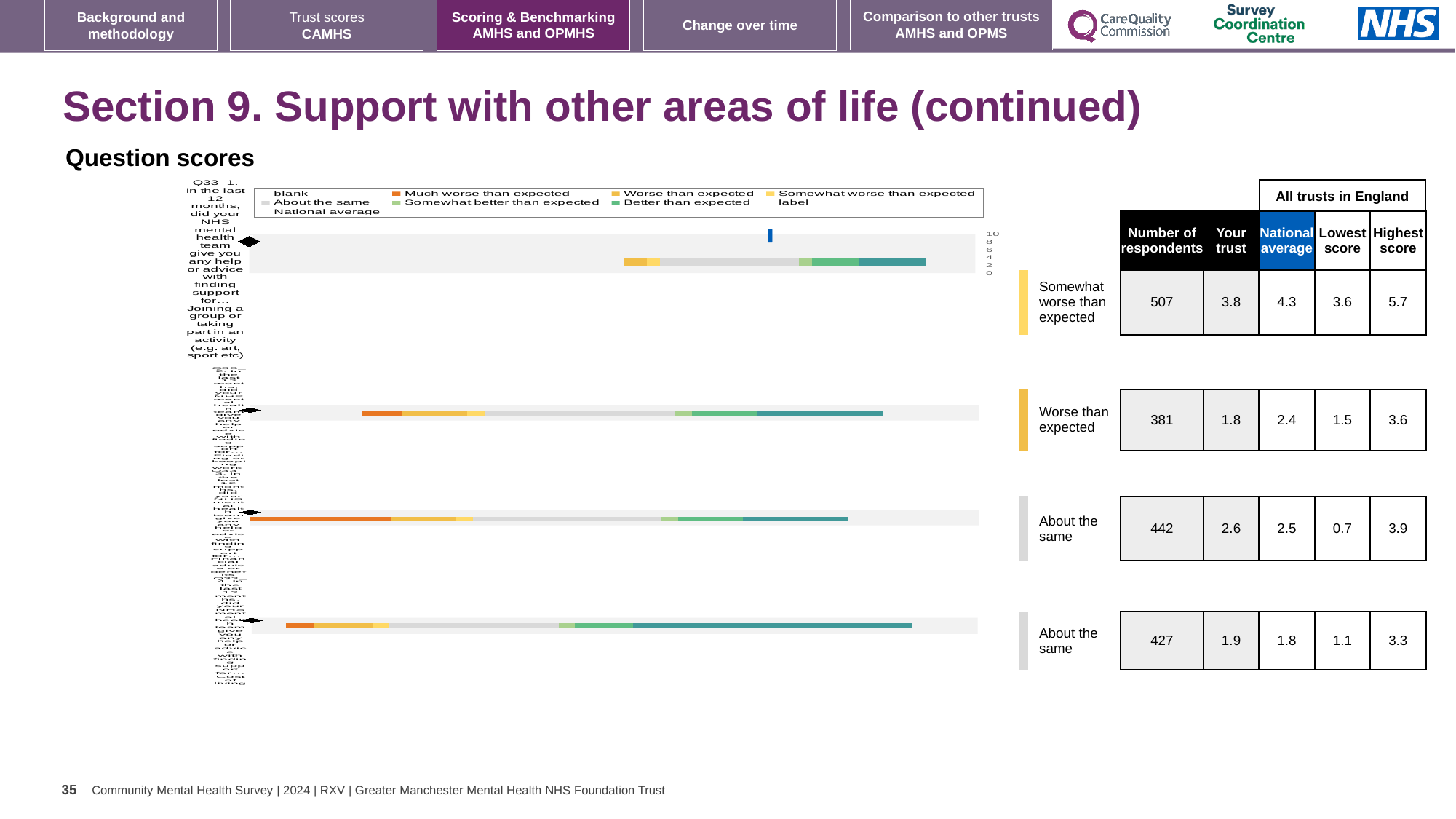
In the table, what is the 'Your trust' score for the first row (Q33_1)? 3.8 What kind of chart is shown on the slide? bar chart In the table, what is the highest score for the second row (Worse than expected)? 3.6 Which row in the table has the highest number of respondents? the first row (Q33_1, 507 respondents) How many horizontal bars are plotted in the chart? 4 For the third row (About the same, 442 respondents), is the 'Your trust' score or the national average larger? Your trust (2.6) In the table, what is the national average for the first row (Q33_1)? 4.3 In the table, how many respondents are listed for the first row (Q33_1, Joining a group or taking part in an activity)? 507 In the table, what is the lowest score for the third row (About the same, 442 respondents)? 0.7 What is the difference between the national average and the 'Your trust' score for the first row (Q33_1)? 0.5 How many entries does the chart legend list? 9 What is the highest value shown on the chart's axis? 10